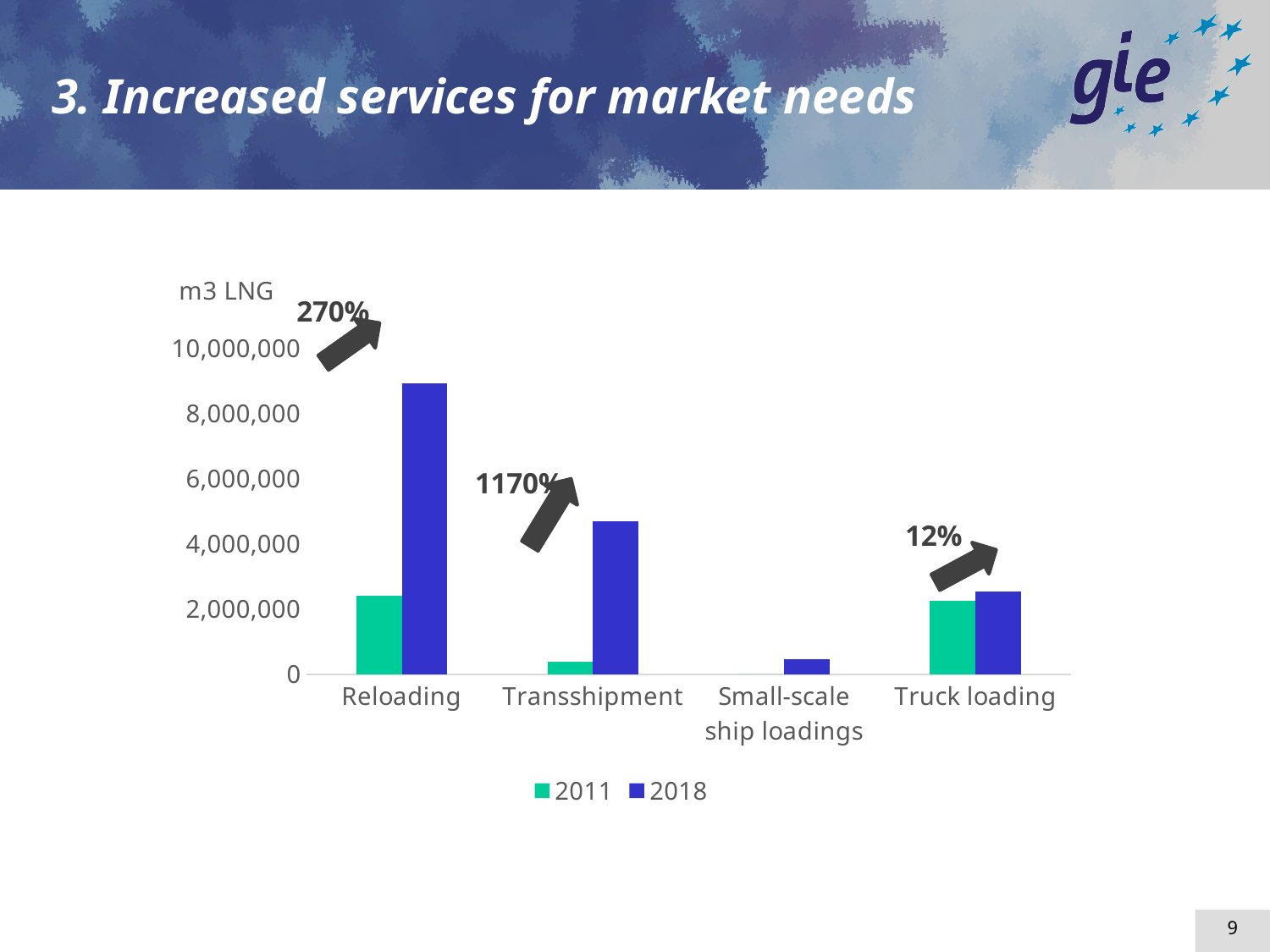
Is the 2018 value for Transshipment greater or less than 4,000,000? greater How many series does the chart's legend list? 2 Which category has the lowest value for 2011? Small-scale ship loadings What percentage increase is annotated above the Transshipment bars? 1170% Is the 2018 value for Reloading greater or less than 8,000,000? greater Which is larger for Transshipment, the 2011 value or the 2018 value? 2018 How many categories are shown on the x axis of the chart? 4 Is the 2011 value for Transshipment greater or less than 2,000,000? less Which category has the lowest value for 2018? Small-scale ship loadings What kind of chart is shown on the slide? bar chart What unit is shown at the top of the vertical axis? m3 LNG Which category has the highest value for 2018? Reloading